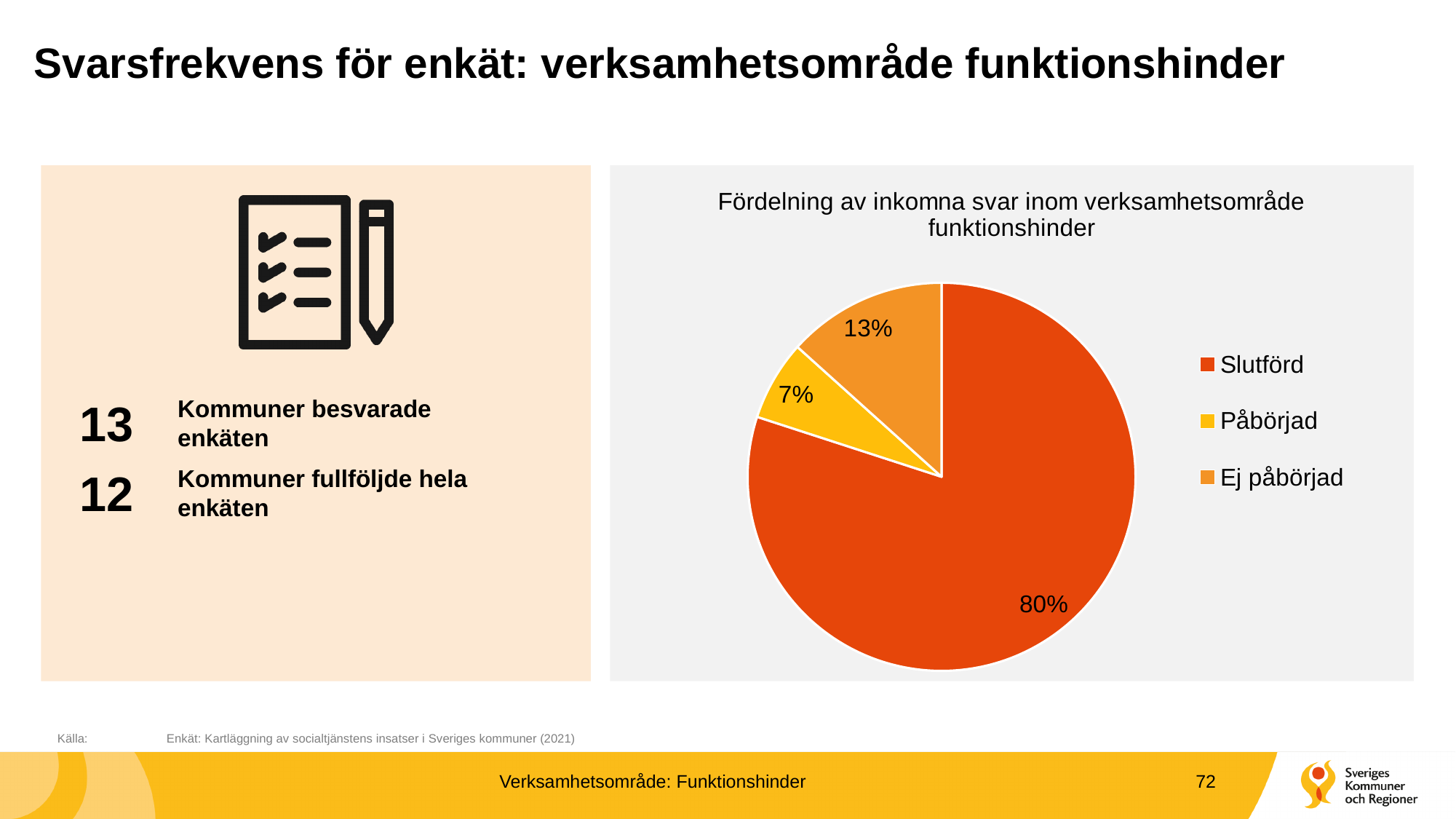
Which category has the largest slice of the pie? Slutförd What share of the pie is Ej påbörjad? 13% How many slices does the pie chart have? 3 Which is larger, the share for Ej påbörjad or the share for Påbörjad? Ej påbörjad What colour is the Påbörjad slice? yellow What type of chart is shown on the slide? pie chart Which category has the smallest slice of the pie? Påbörjad How many entries does the legend list? 3 What is the title of the chart? Fördelning av inkomna svar inom verksamhetsområde funktionshinder What share of the pie is Slutförd? 80% What share of the pie is Påbörjad? 7% What is the difference in percentage points between Slutförd and Ej påbörjad? 67